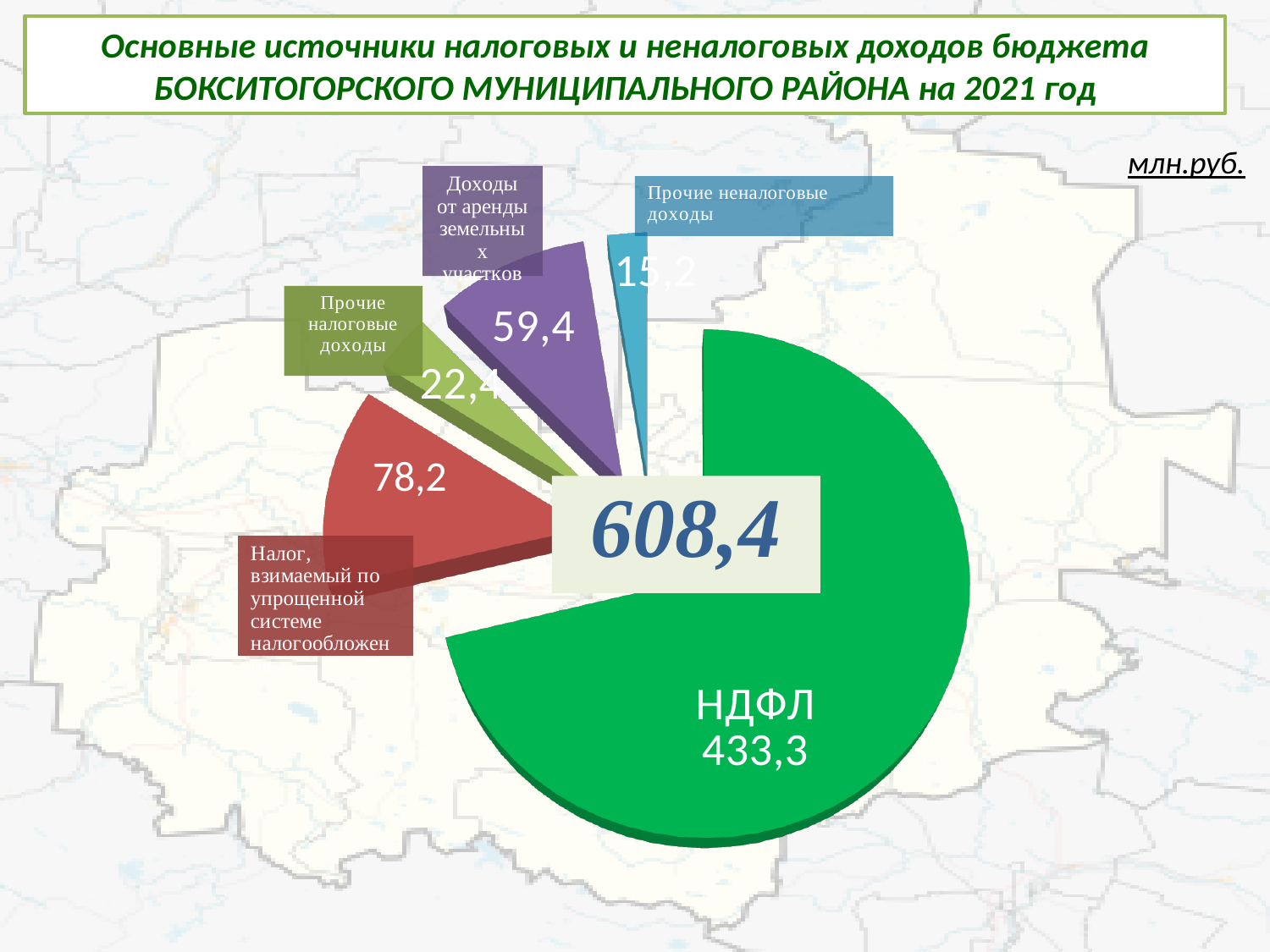
What is the value for Налог, взимаемый по упрощенной системе налогообложения? 78,2 What is the value for Доходы от аренды земельных участков? 59,4 What is the difference between НДФЛ and Налог, взимаемый по упрощенной системе налогообложения? 355,1 What is the value for Прочие неналоговые доходы? 15,2 Which category has the largest slice of the pie? НДФЛ How many slices does the pie chart have? 5 What is the value for Прочие налоговые доходы? 22,4 What kind of chart is shown on the slide? Pie chart Which is larger: Доходы от аренды земельных участков or Прочие налоговые доходы? Доходы от аренды земельных участков What total value is shown in the centre of the pie chart? 608,4 Which category has the smallest slice of the pie? Прочие неналоговые доходы What is the value for НДФЛ? 433,3